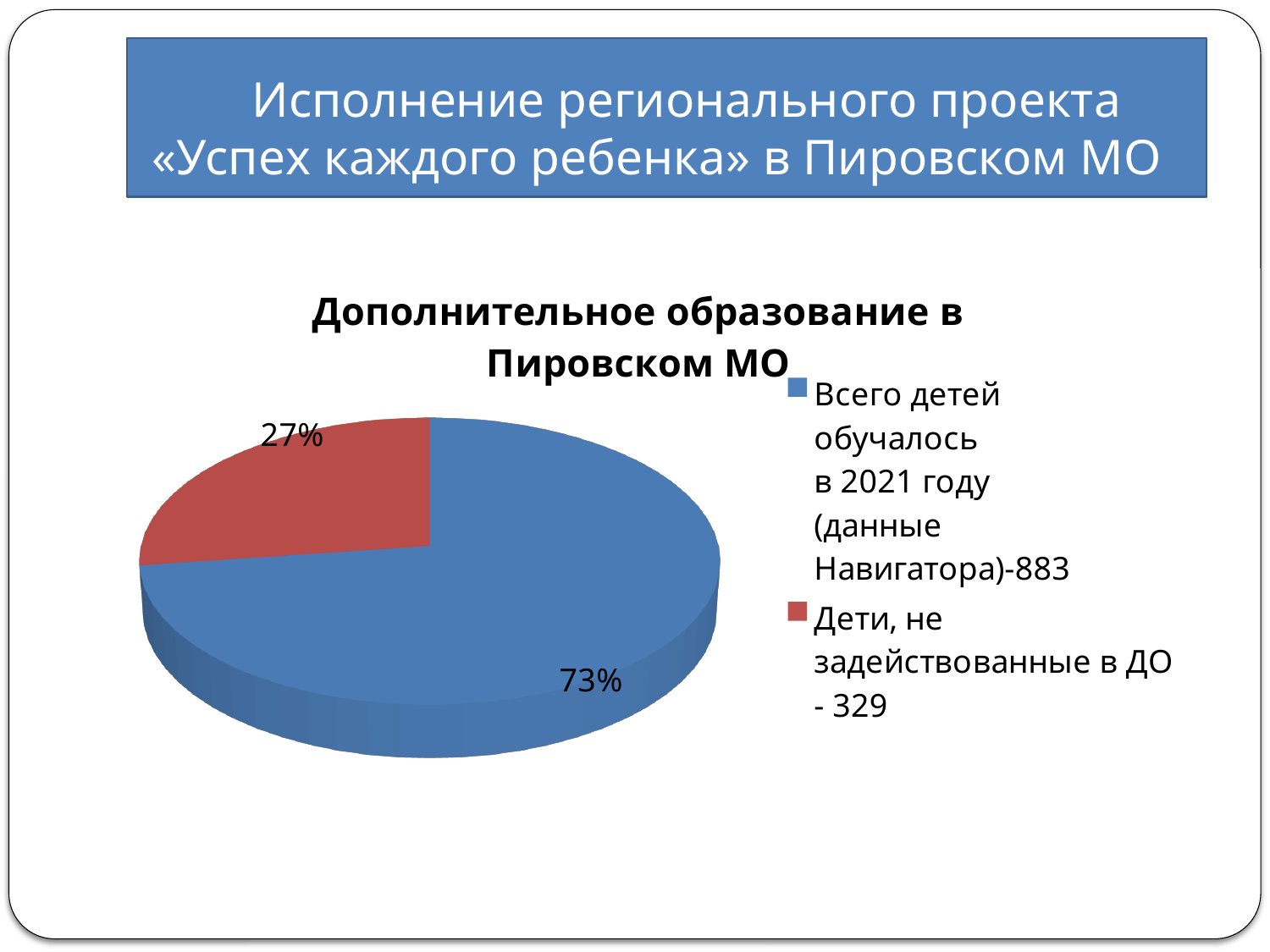
By how many percentage points does the 73% slice exceed the 27% slice? 46 percentage points What colour is the slice representing "Дети, не задействованные в ДО"? red What kind of chart is shown on the slide? pie chart What is the title of the chart? Дополнительное образование в Пировском МО Which slice is the largest in the pie chart? Всего детей обучалось в 2021 году (данные Навигатора) How many slices does the pie chart have? 2 How many entries does the legend list? 2 According to the legend, how many children were not involved in ДО? 329 What share of the pie is labelled for the slice "Дети, не задействованные в ДО"? 27% Which is larger: the share of children enrolled in 2021 or the share of children not involved in ДО? Всего детей обучалось в 2021 году (данные Навигатора) What share of the pie is labelled for the slice "Всего детей обучалось в 2021 году (данные Навигатора)"? 73% Which slice is the smallest in the pie chart? Дети, не задействованные в ДО